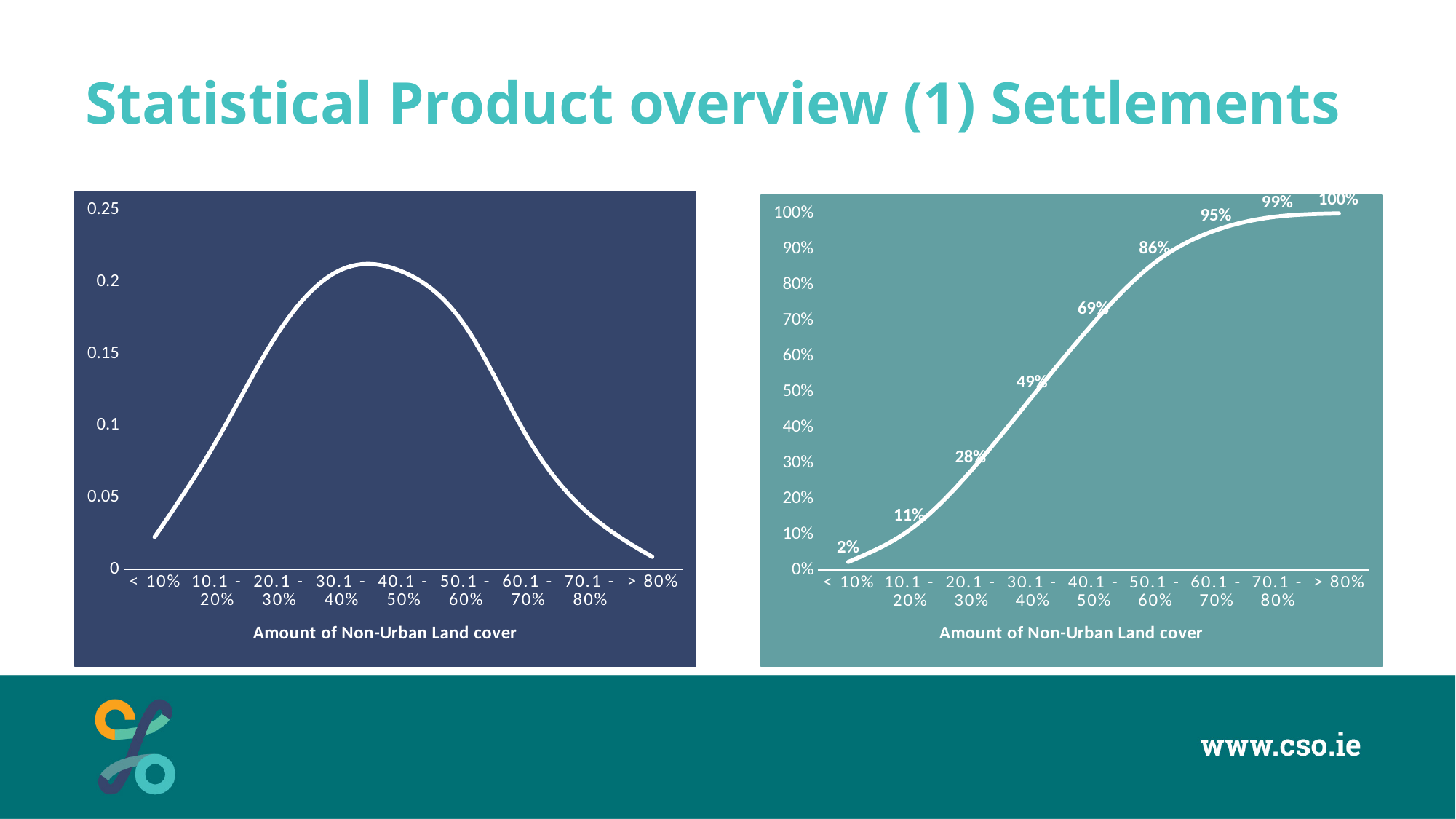
On the right-hand chart, what is the value for the < 10% category? 2% On the right-hand chart, what is the value for the 30.1 - 40% category? 49% How many categories are shown on the x axis of the left-hand chart? 9 What kind of chart is the left-hand chart? line chart On the right-hand chart, what is the difference between the values for 40.1 - 50% and 20.1 - 30%? 41% What is the x-axis title of the right-hand chart? Amount of Non-Urban Land cover On the right-hand chart, do the values rise or fall as you move from left to right along the x axis? rise On the left-hand chart, is the value for 30.1 - 40% greater or less than 0.2? greater On the right-hand chart, which category has the lowest value? < 10% On the right-hand chart, what is the value for the 60.1 - 70% category? 95% On the right-hand chart, which category has the highest value? > 80%